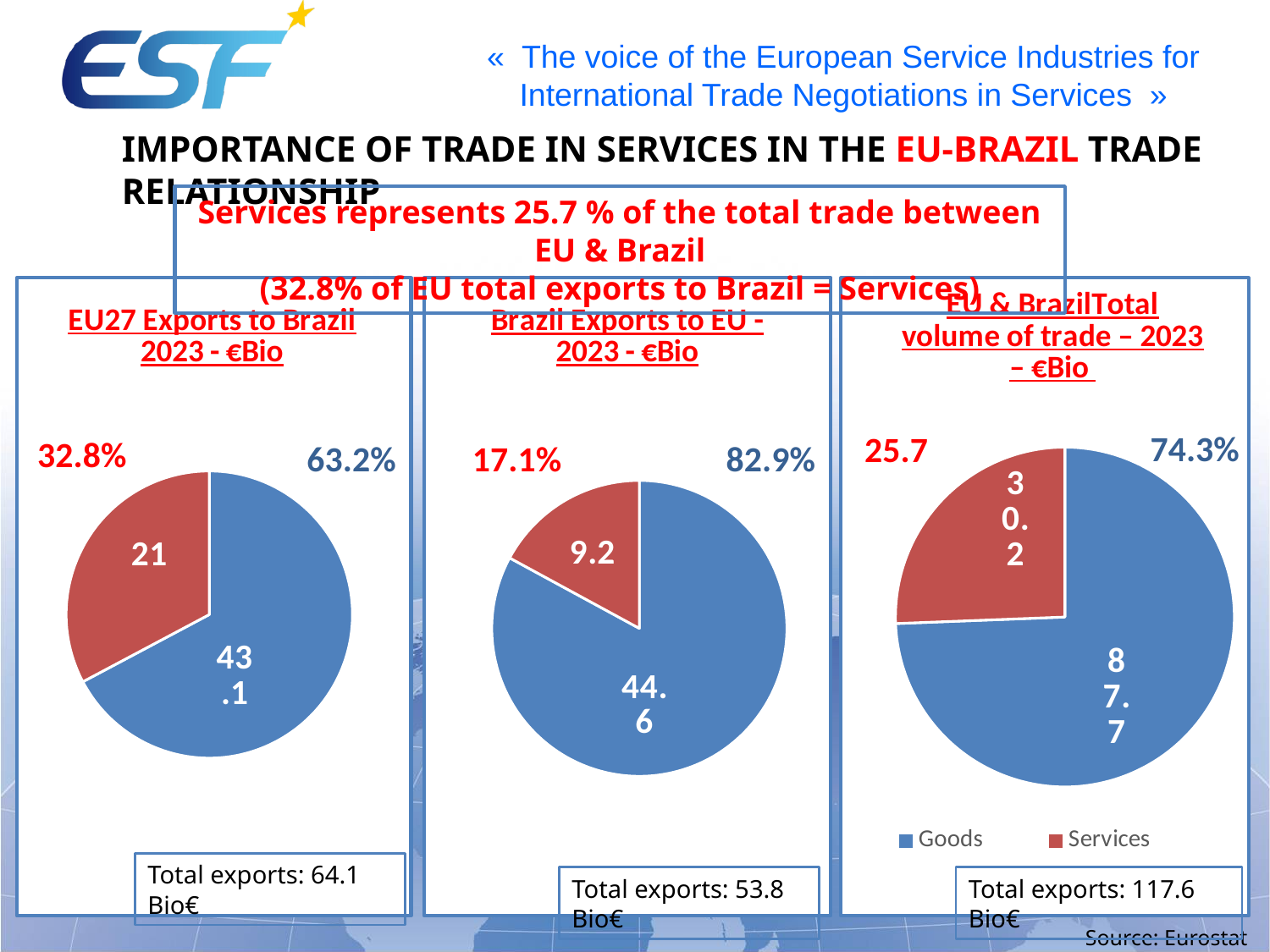
In the 'Brazil Exports to EU - 2023 - €Bio' chart, which slice is larger, Goods or Services? Goods In the 'EU27 Exports to Brazil 2023 - €Bio' chart, what share of the pie is Services? 32.8% How many categories does the legend list for the 'EU & Brazil Total volume of trade – 2023 – €Bio' chart? 2 In the 'EU & Brazil Total volume of trade – 2023 – €Bio' chart, what is the value for Services? 30.2 In the 'EU27 Exports to Brazil 2023 - €Bio' chart, what is the value for Goods? 43.1 In the 'Brazil Exports to EU - 2023 - €Bio' chart, what share of the pie is Goods? 82.9% In the 'EU & Brazil Total volume of trade – 2023 – €Bio' chart, which colour represents Services? Red In the 'EU27 Exports to Brazil 2023 - €Bio' chart, what is the value for Services? 21 What kind of chart is used for 'EU27 Exports to Brazil 2023 - €Bio'? Pie chart In the 'EU & Brazil Total volume of trade – 2023 – €Bio' chart, what is the difference between the Goods and Services values? 57.5 In the 'EU & Brazil Total volume of trade – 2023 – €Bio' chart, what is the value for Goods? 87.7 In the 'Brazil Exports to EU - 2023 - €Bio' chart, what is the value for Services? 9.2